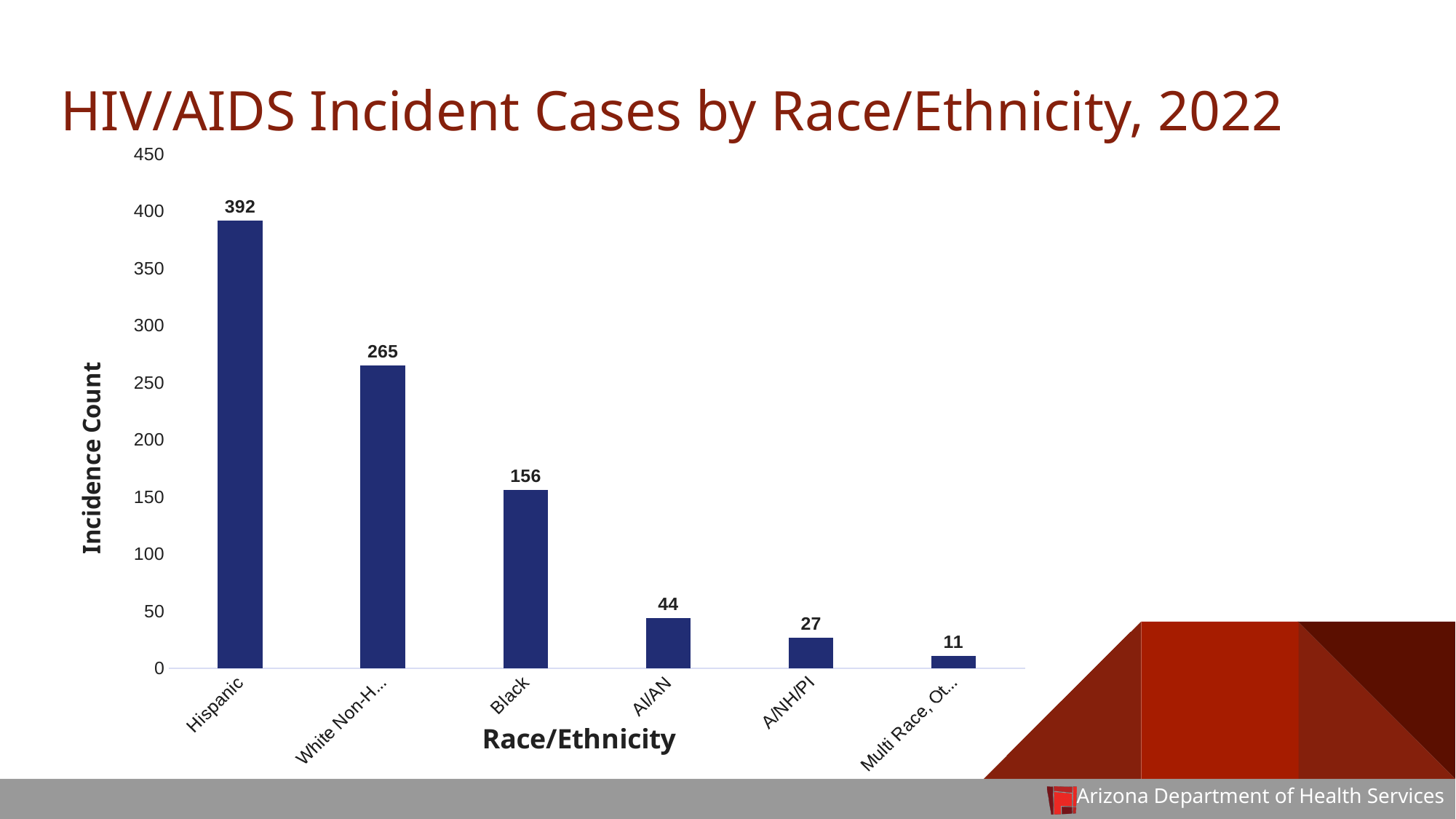
Which race/ethnicity category has the lowest incidence count? Multi Race, Ot... What is the difference between the incidence counts for AI/AN and A/NH/PI? 17 Which has a larger incidence count, Black or AI/AN? Black What is the title of the chart? HIV/AIDS Incident Cases by Race/Ethnicity, 2022 What kind of chart is shown on the slide? Bar chart How many race/ethnicity categories are shown on the chart? 6 What is the incidence count for A/NH/PI? 27 What is the incidence count for AI/AN? 44 What is the difference between the incidence counts for Hispanic and Black? 236 What is the incidence count for Hispanic? 392 Which race/ethnicity category has the highest incidence count? Hispanic What is the incidence count for Black? 156